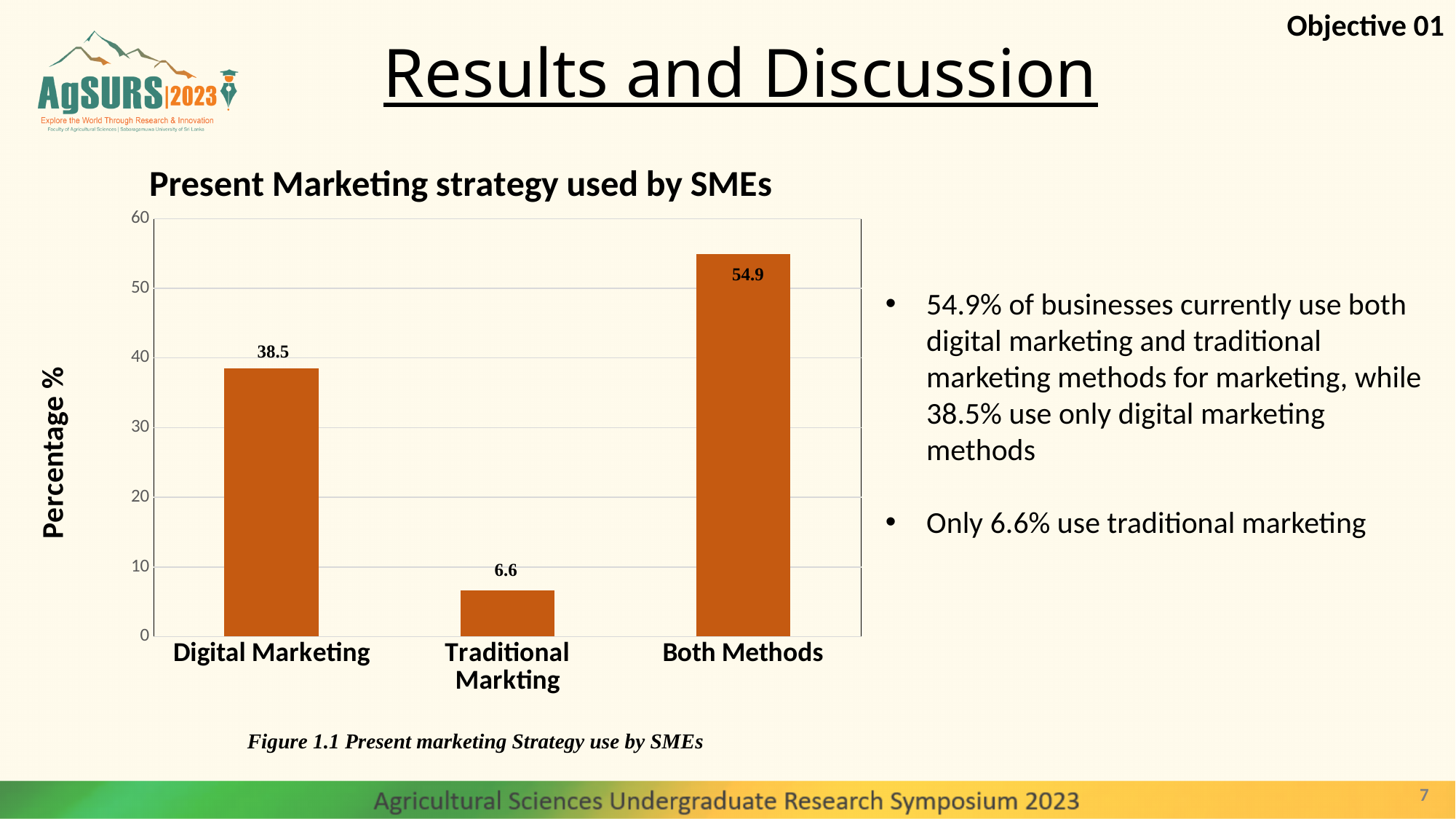
Which is larger, the value for Digital Marketing or the value for Both Methods? Both Methods What is the value for Both Methods? 54.9 Is the value for Traditional Markting greater or less than 10? less What kind of chart is shown on the slide? bar chart What is the difference between the values for Digital Marketing and Traditional Markting? 31.9 What is the value for Traditional Markting? 6.6 Which category has the highest value? Both Methods What is the value for Digital Marketing? 38.5 What is the title of the chart? Present Marketing strategy used by SMEs How many categories are shown on the x axis? 3 Which category has the lowest value? Traditional Markting What is the difference between the values for Both Methods and Digital Marketing? 16.4